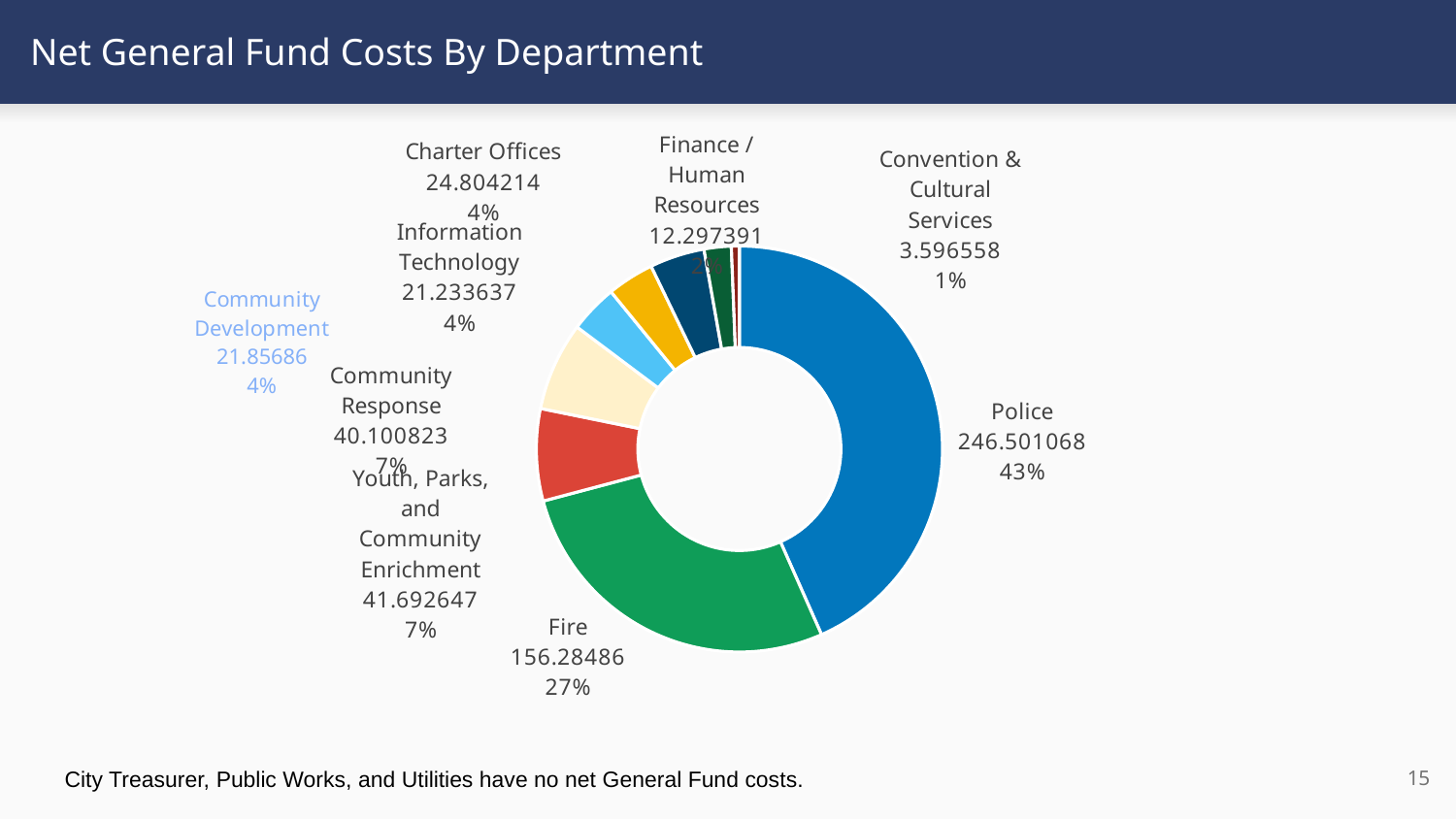
How many departments are shown in the chart? 9 Which department has the smallest net General Fund cost? Convention & Cultural Services What is the difference between the net General Fund costs of Police and Fire? 90.216208 What is the net General Fund cost for Community Response? 40.100823 What kind of chart is shown on the slide? doughnut chart What share of net General Fund costs does Fire account for? 27% Which department has the largest net General Fund cost? Police What is the net General Fund cost for Police? 246.501068 What is the net General Fund cost for Fire? 156.28486 Which has a larger net General Fund cost, Charter Offices or Information Technology? Charter Offices What share of net General Fund costs does Police account for? 43% What is the net General Fund cost for Convention & Cultural Services? 3.596558